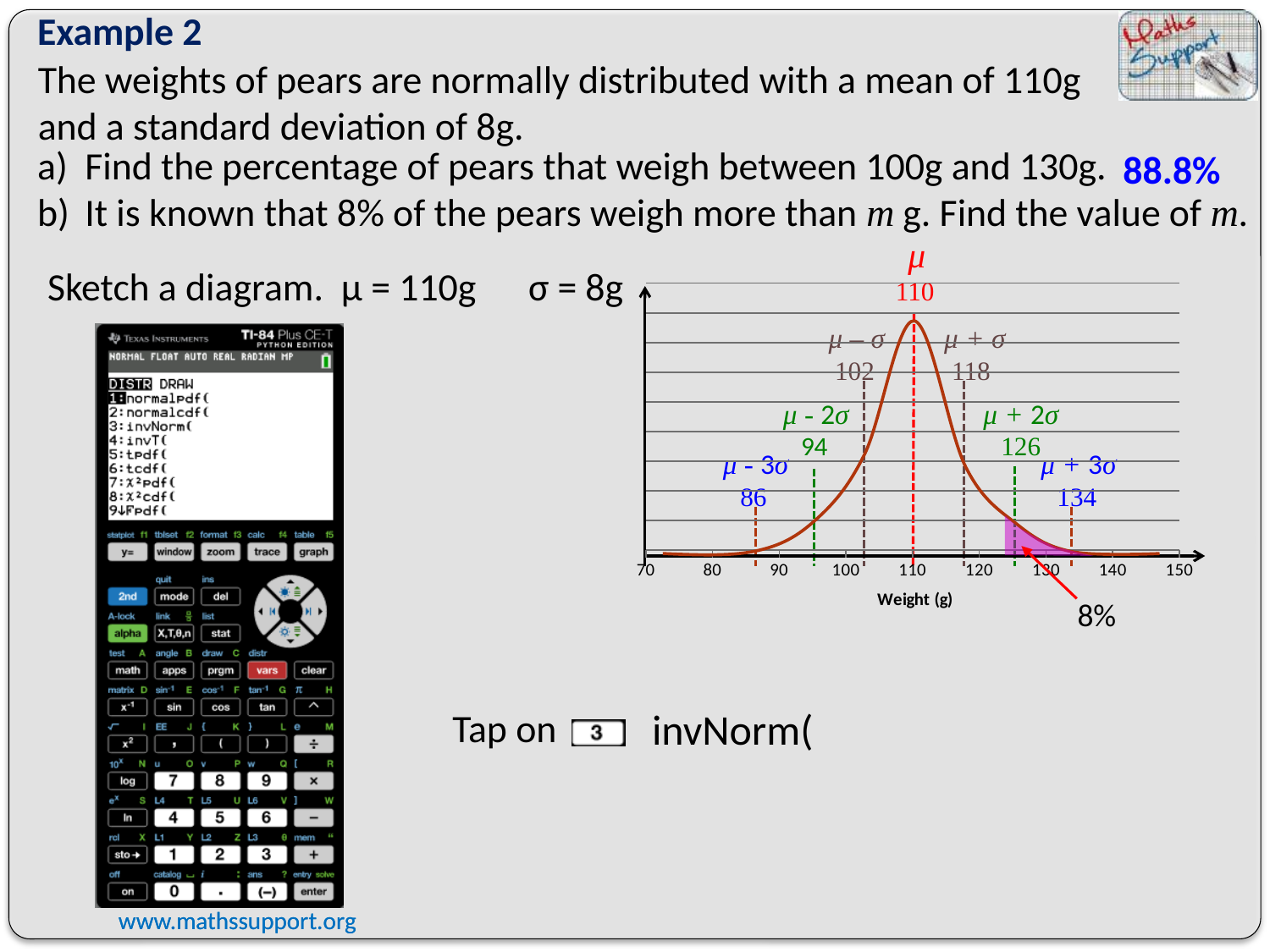
What value is marked at μ - 2σ on the diagram? 94 What value is marked at μ + σ on the diagram? 118 What value is marked at μ + 3σ on the diagram? 134 What is the label on the horizontal axis of the normal distribution diagram? Weight (g) What value is marked at μ - 3σ on the diagram? 86 What value is marked at μ – σ on the diagram? 102 At which weight does the curve reach its highest point? 110 What value is marked at the mean μ on the normal distribution diagram? 110 What value is marked at μ + 2σ on the diagram? 126 What is the difference between the values marked at μ + σ and μ – σ on the diagram? 16 What kind of curve is plotted on the diagram? Normal distribution curve What percentage is the shaded region in the right tail of the curve labelled with? 8%